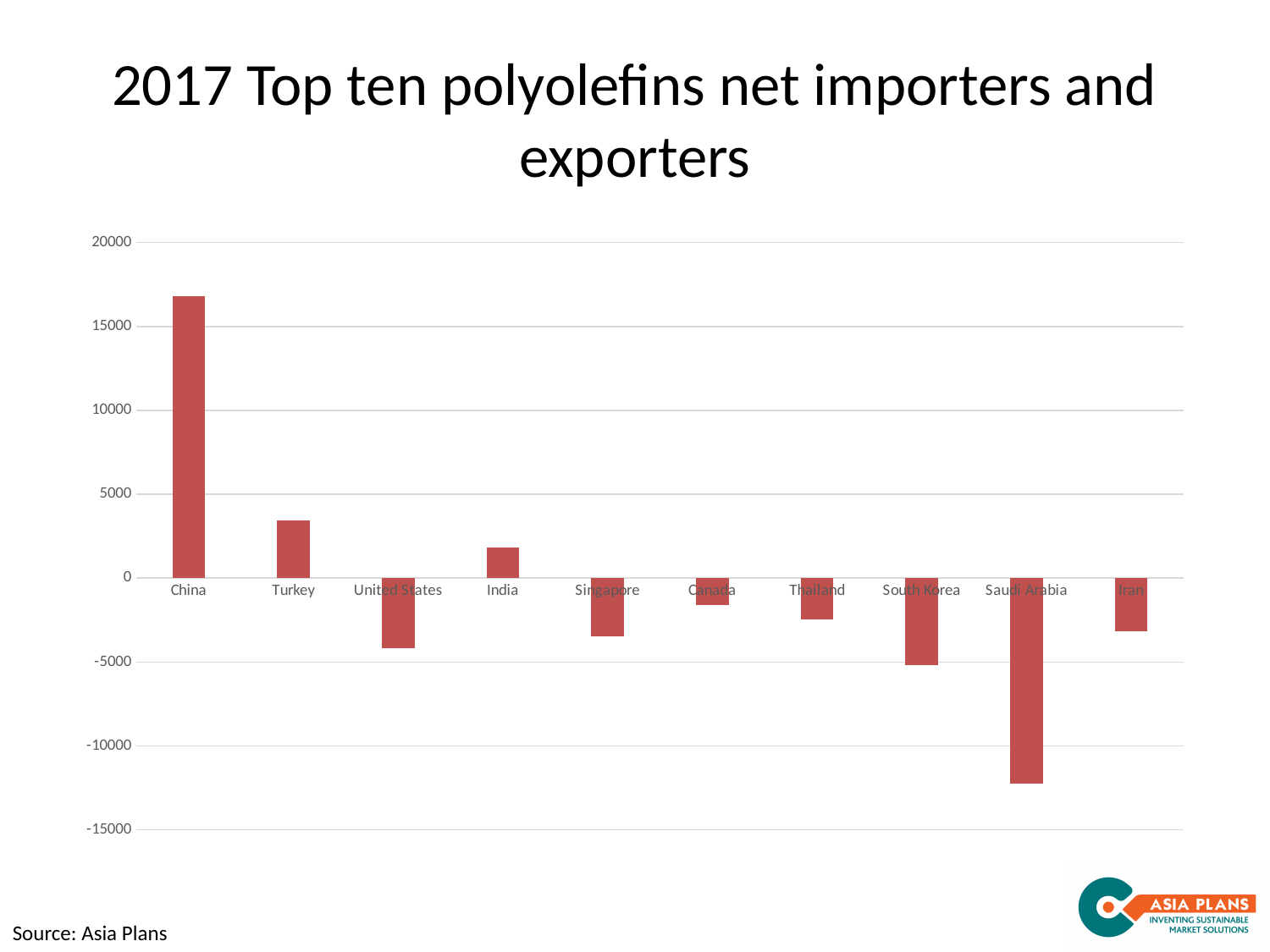
Is the value for Saudi Arabia greater or less than -10000? less Which country has the lowest value on the chart? Saudi Arabia Which has the larger value, South Korea or Saudi Arabia? South Korea How many countries have a positive (above zero) value on the chart? 3 Which country has the highest value on the chart? China Is the value for Turkey greater or less than 5000? less What is the title of the slide? 2017 Top ten polyolefins net importers and exporters Is the value for China greater or less than 15000? greater Which has the larger value, Turkey or India? Turkey What kind of chart is shown on the slide? bar chart How many countries are shown on the chart? 10